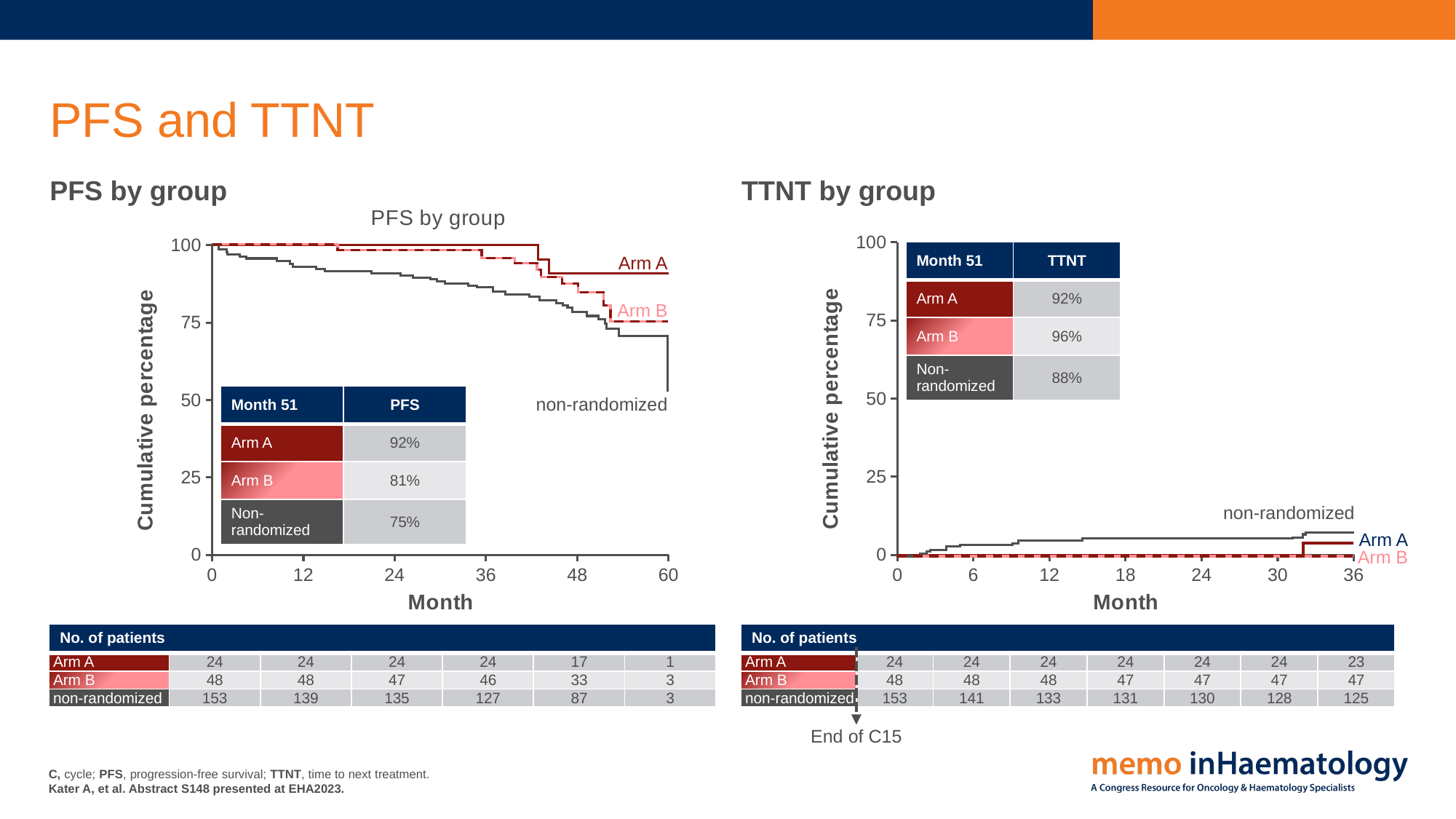
In the PFS by group chart, what is the difference between the Month 51 PFS of Arm A and Arm B? 11 percentage points What is the label of the x axis in the PFS by group chart? Month How many groups are plotted in the PFS by group chart? 3 In the PFS by group chart, which group has the highest PFS at Month 51? Arm A In the PFS by group chart, is the cumulative percentage for the non-randomized group at month 60 greater or less than 75? less In the PFS by group chart, what is the PFS for the non-randomized group at Month 51? 75% In the TTNT by group chart, which group has the lowest TTNT value at Month 51? Non-randomized In the TTNT by group chart, which has the higher Month 51 value, Arm A or Arm B? Arm B In the TTNT by group chart, is the cumulative percentage for the non-randomized group at month 36 greater or less than 25? less In the TTNT by group chart, what is the TTNT value for Arm B at Month 51? 96% What kind of chart is the TTNT by group chart? Line chart In the PFS by group chart, what is the PFS for Arm A at Month 51? 92%